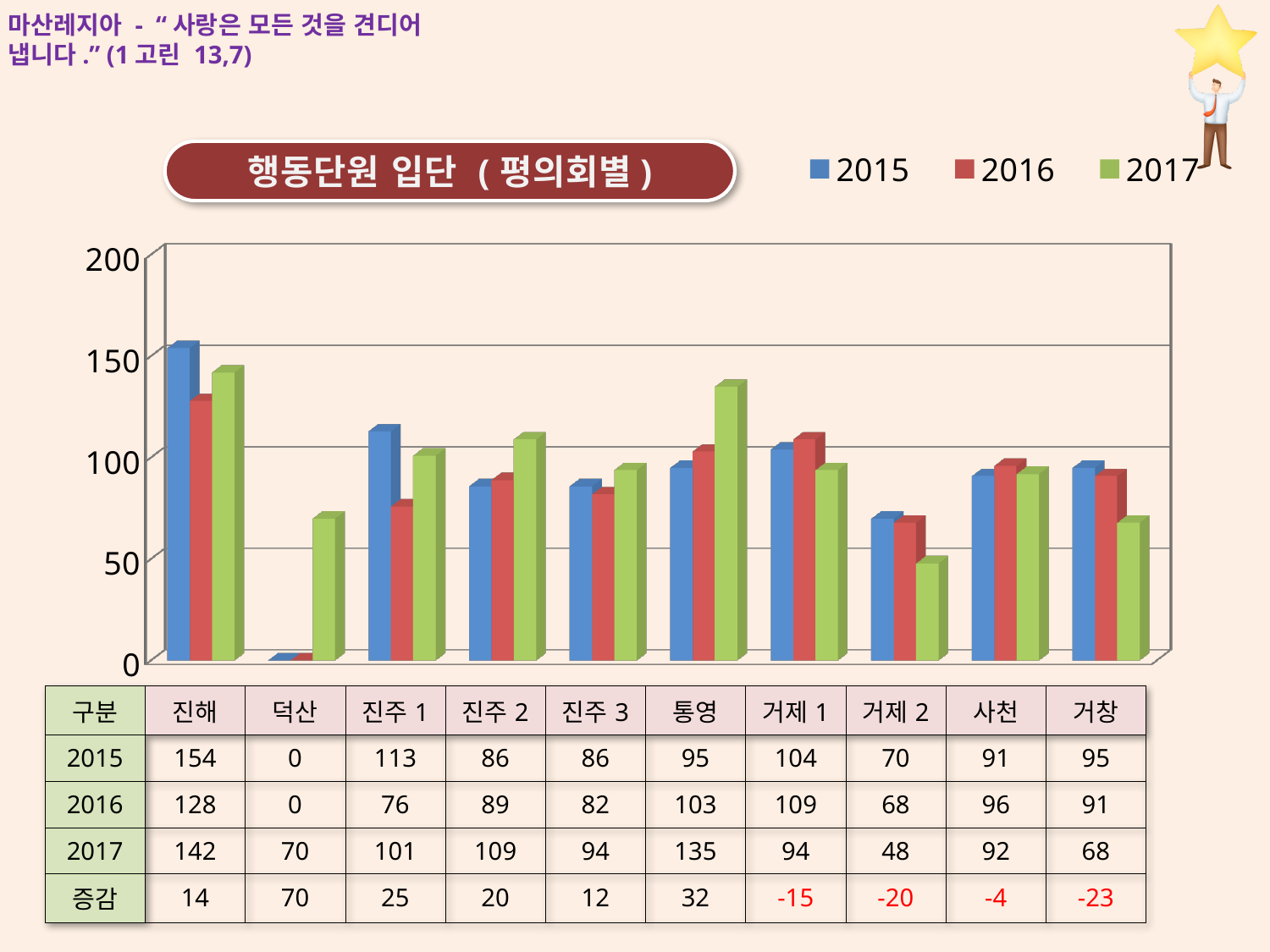
What is the title of the chart? 행동단원 입단 ( 평의회별 ) Which is larger for 거제 2: the 2016 value or the 2017 value? 2016 Which category has the lowest 2015 value? 덕산 Which category has the highest 2017 value? 진해 What is the difference between the 2017 and 2015 values for 거창? -23 How many series does the legend list? 3 What kind of chart is shown on the slide? bar chart What is the 2017 value for 통영? 135 How many categories (평의회) are shown along the x axis? 10 Is the 2017 value for 덕산 greater or less than 100? less What is the 2015 value for 진해? 154 What is the 2016 value for 진주 1? 76